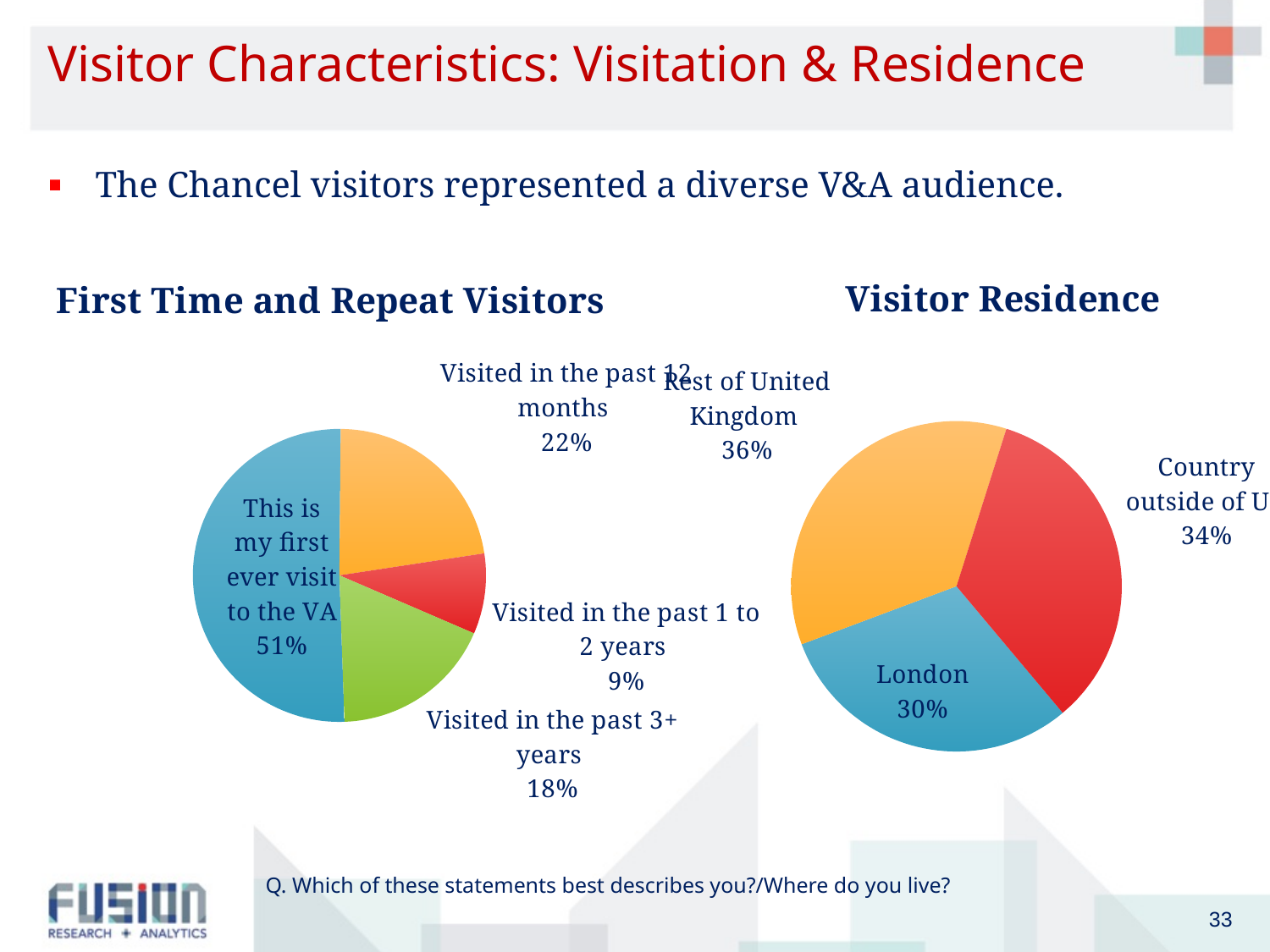
In the 'First Time and Repeat Visitors' chart, what is the difference between the share who visited in the past 3+ years and the share who visited in the past 1 to 2 years? 9% In the 'Visitor Residence' chart, what percentage of visitors live in the Rest of United Kingdom? 36% In the 'First Time and Repeat Visitors' chart, which category has the largest share? This is my first ever visit to the VA How many slices does the 'First Time and Repeat Visitors' pie chart have? 4 In the 'First Time and Repeat Visitors' chart, which category has the smallest share? Visited in the past 1 to 2 years In the 'Visitor Residence' chart, which is larger: the share for London or the share for Rest of United Kingdom? Rest of United Kingdom In the 'Visitor Residence' chart, what is the difference between the Rest of United Kingdom share and the London share? 6% In the 'First Time and Repeat Visitors' chart, what percentage of visitors said this was their first ever visit to the VA? 51% What kind of chart is the 'First Time and Repeat Visitors' chart? Pie chart In the 'Visitor Residence' chart, what percentage of visitors live in London? 30% How many slices does the 'Visitor Residence' pie chart have? 3 In the 'First Time and Repeat Visitors' chart, what share of visitors visited in the past 12 months? 22%